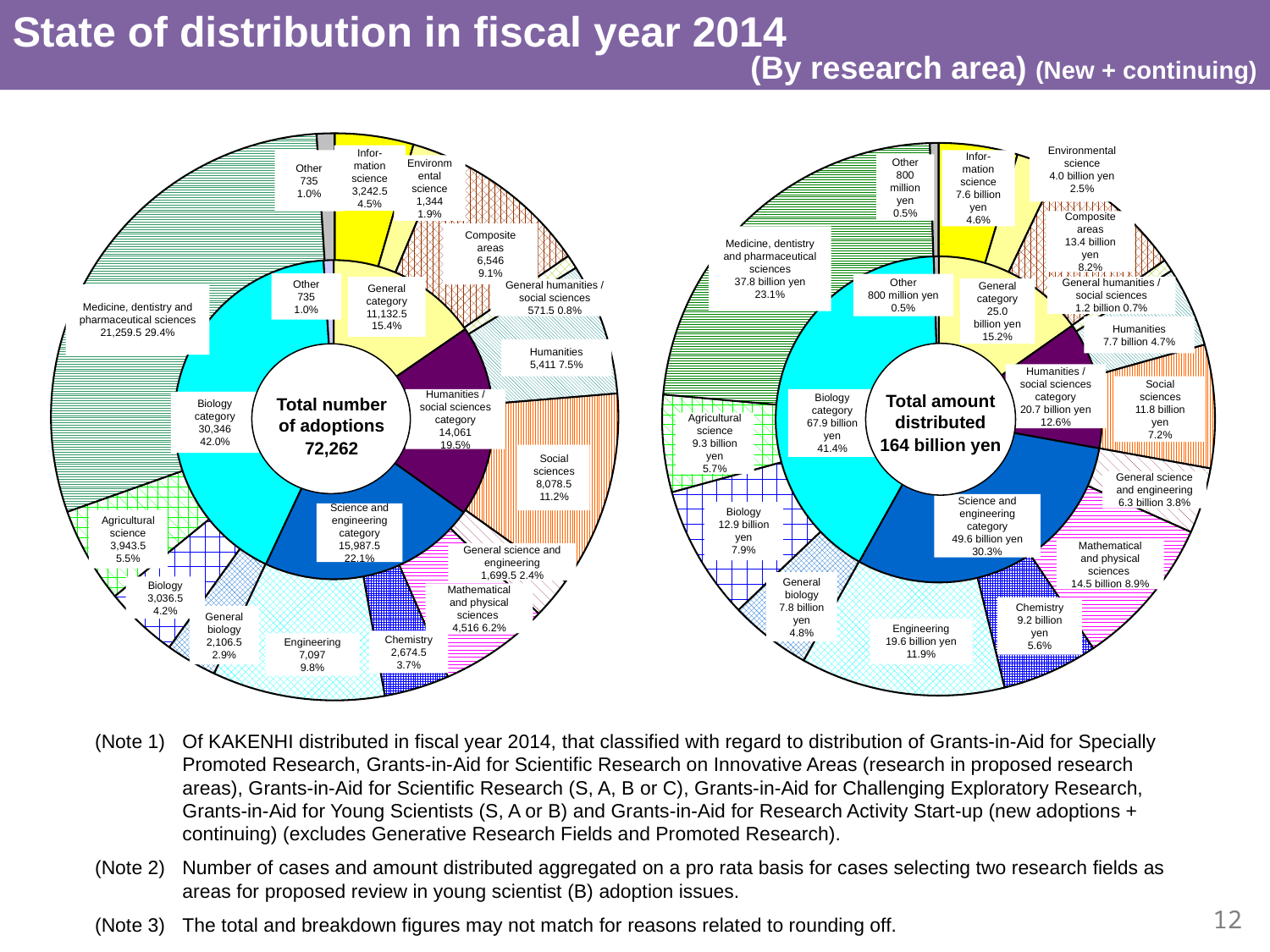
In the 'Total number of adoptions' chart, what is the total number of adoptions shown in the centre? 72,262 What type of chart is used on this slide? Pie chart (doughnut) In the 'Total amount distributed' chart, which received more funding: Social sciences or Humanities? Social sciences In the 'Total amount distributed' chart, what is the total amount distributed shown in the centre? 164 billion yen In the 'Total amount distributed' chart, how much was distributed to the Science and engineering category? 49.6 billion yen In the 'Total amount distributed' chart, which inner-ring category has the largest amount distributed? Biology category In the 'Total number of adoptions' chart, how many adoptions are in Medicine, dentistry and pharmaceutical sciences? 21,259.5 In the 'Total amount distributed' chart, what percentage share does Medicine, dentistry and pharmaceutical sciences have? 23.1% In the 'Total number of adoptions' chart, which research area in the outer ring has the smallest number of adoptions? General humanities / social sciences In the 'Total number of adoptions' chart, what is the difference in adoptions between Engineering (7,097) and Chemistry (2,674.5)? 4,422.5 In the 'Total number of adoptions' chart, what share of adoptions does the Biology category account for? 42.0% In the 'Total number of adoptions' chart, which research area in the outer ring has the largest number of adoptions? Medicine, dentistry and pharmaceutical sciences